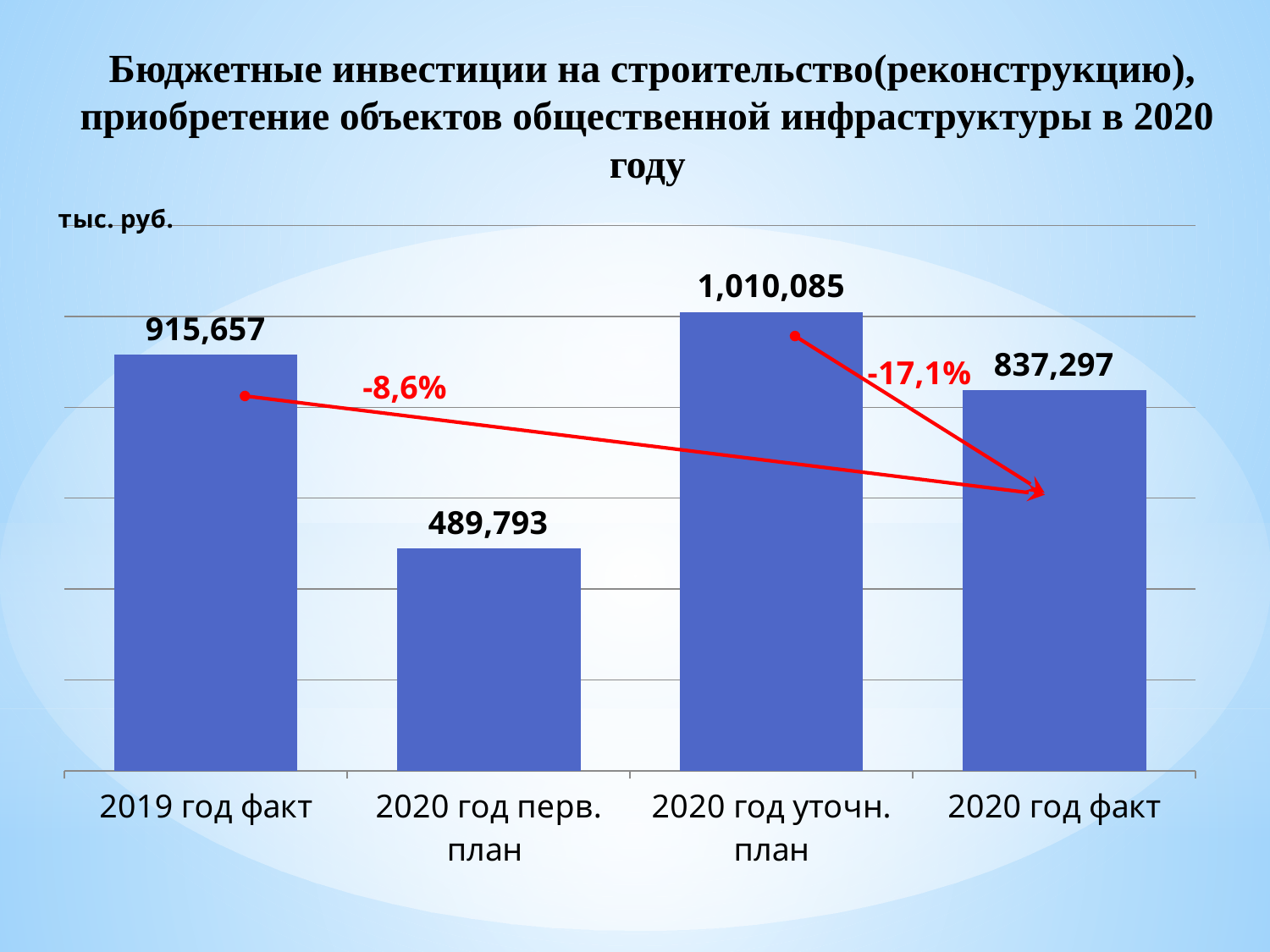
What is the difference between 2019 год факт and 2020 год факт? 78,360 What is the difference between 2020 год уточн. план and 2020 год факт? 172,788 What is the value for 2020 год факт? 837,297 What is the value for 2020 год перв. план? 489,793 What unit is indicated for the values on the chart? тыс. руб. What is the value for 2020 год уточн. план? 1,010,085 How many categories are shown on the chart? 4 Which is larger, 2019 год факт or 2020 год факт? 2019 год факт What is the value for 2019 год факт? 915,657 Which category has the lowest value? 2020 год перв. план What kind of chart is shown on the slide? Bar chart Which category has the highest value? 2020 год уточн. план